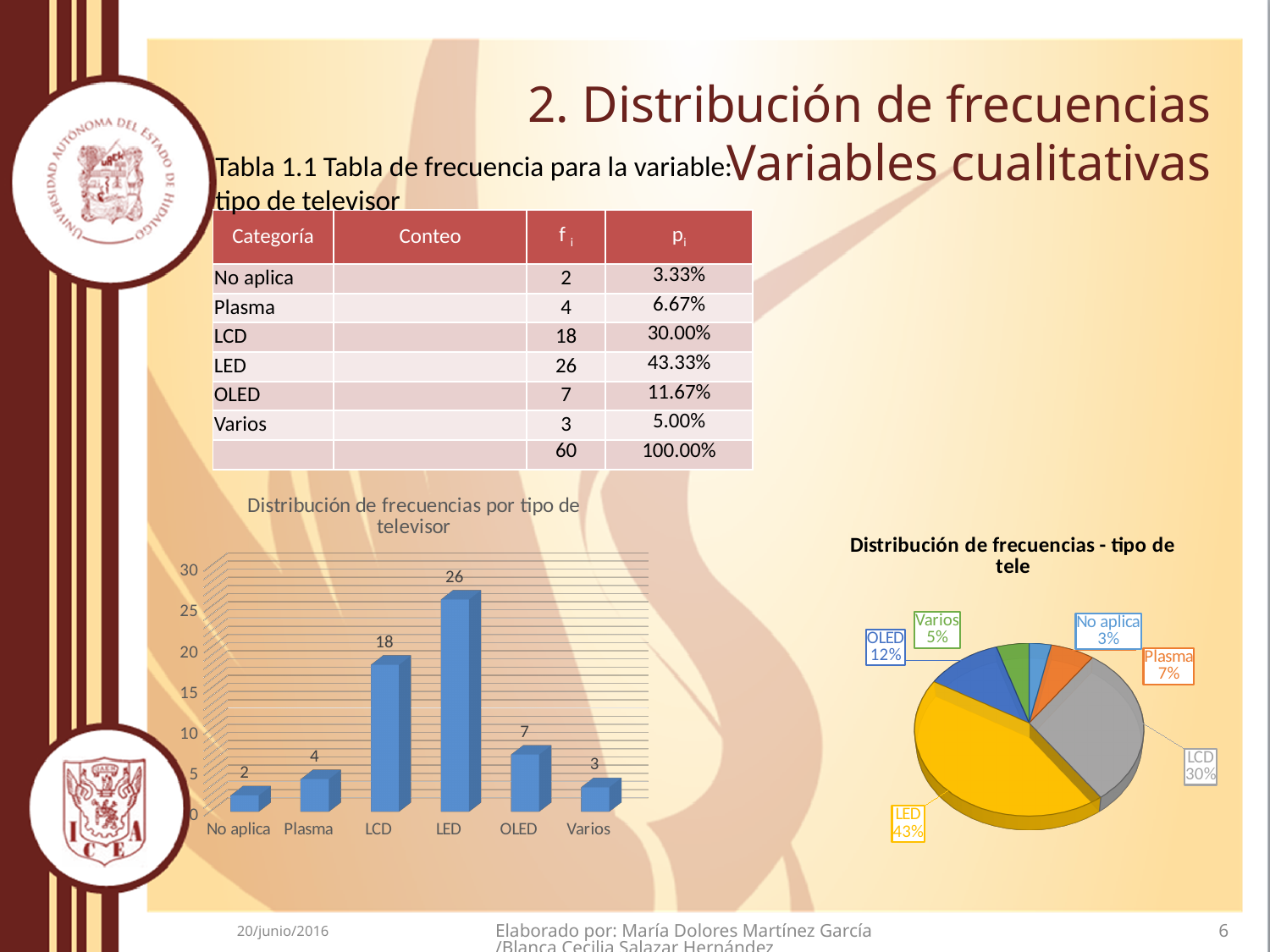
In the pie chart 'Distribución de frecuencias - tipo de tele', which slice is the smallest? No aplica In the bar chart 'Distribución de frecuencias por tipo de televisor', how many categories are shown on the x axis? 6 In the pie chart 'Distribución de frecuencias - tipo de tele', what share does OLED have? 12% In the bar chart 'Distribución de frecuencias por tipo de televisor', which category has the lowest value? No aplica In the bar chart 'Distribución de frecuencias por tipo de televisor', which is larger, the value for Plasma or the value for Varios? Plasma In the bar chart 'Distribución de frecuencias por tipo de televisor', what is the value for OLED? 7 What kind of chart is 'Distribución de frecuencias - tipo de tele'? Pie chart In the bar chart 'Distribución de frecuencias por tipo de televisor', what is the value for LCD? 18 In the bar chart 'Distribución de frecuencias por tipo de televisor', what is the difference between the values for LED and LCD? 8 In the bar chart 'Distribución de frecuencias por tipo de televisor', which category has the highest value? LED What kind of chart is 'Distribución de frecuencias por tipo de televisor'? Bar chart In the pie chart 'Distribución de frecuencias - tipo de tele', what share does LED have? 43%